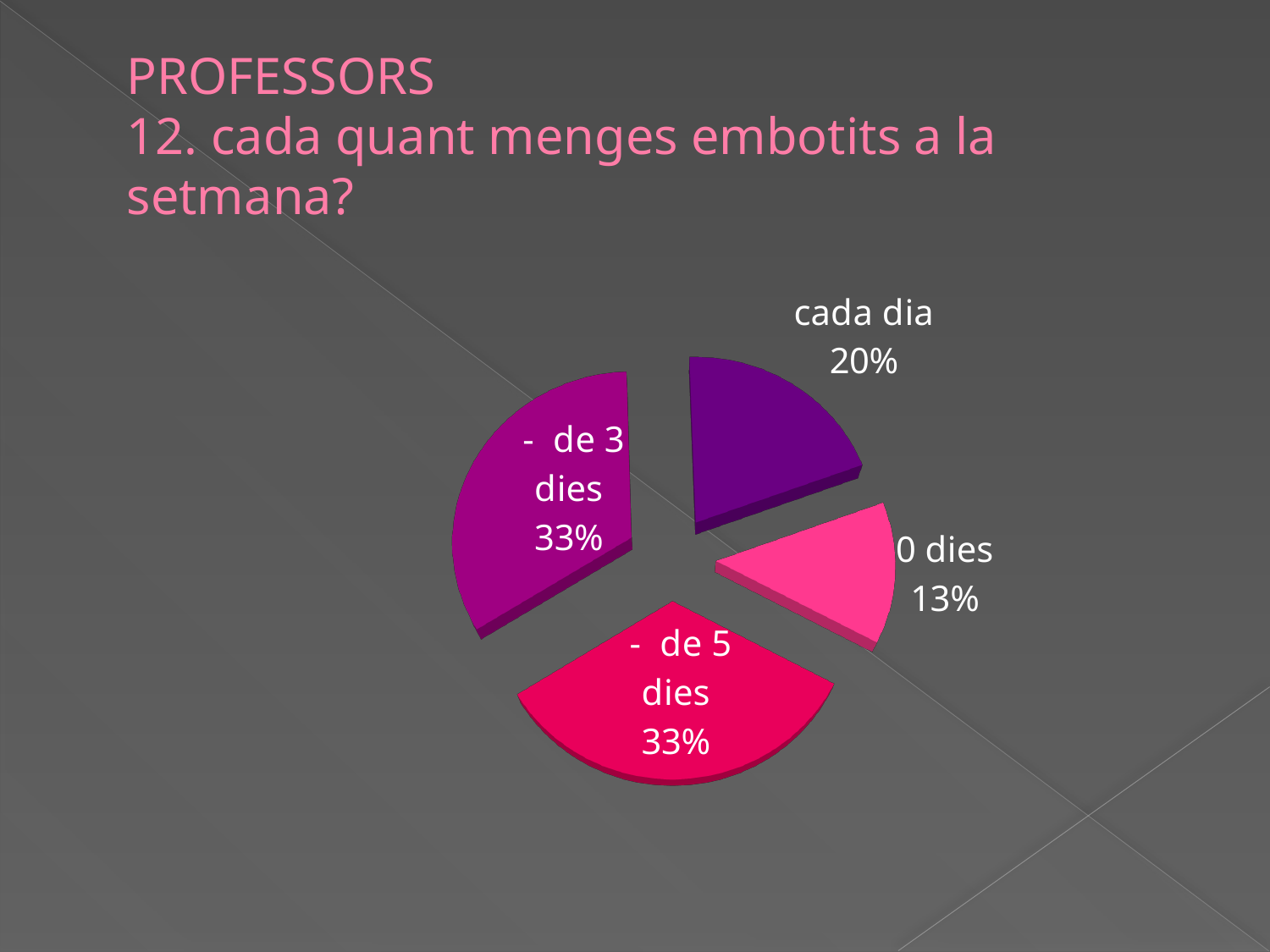
What percentage is shown for the "cada dia" slice? 20% Which category has the smallest share of the pie? 0 dies What percentage is shown for the "0 dies" slice? 13% Which two categories have the same share of the pie? - de 3 dies and - de 5 dies How many slices does the pie chart have? 4 What percentage is shown for the "- de 3 dies" slice? 33% What percentage is shown for the "- de 5 dies" slice? 33% What is the difference in percentage points between the "- de 3 dies" slice and the "cada dia" slice? 13 What is the difference in percentage points between the "cada dia" slice and the "0 dies" slice? 7 What question does the chart title say the pie chart answers? 12. cada quant menges embotits a la setmana? Which is larger, the share for "cada dia" or the share for "0 dies"? cada dia What kind of chart is shown on the slide? pie chart